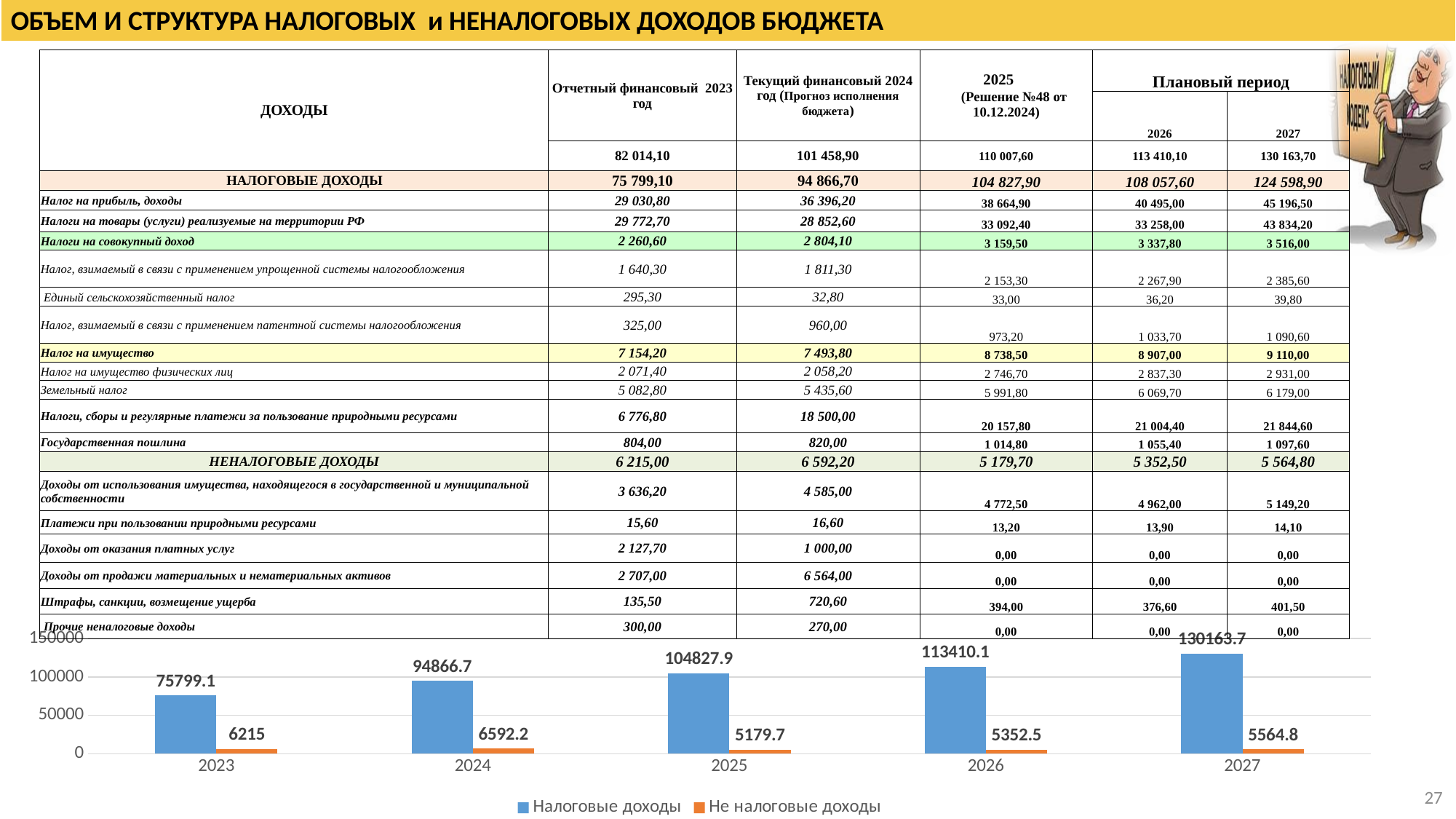
Do the values of Налоговые доходы rise or fall from 2023 to 2027 in the chart? rise What is the difference between Налоговые доходы in 2024 and 2023 in the chart? 19067.6 How many series does the chart legend list? 2 How many years are shown on the x axis of the chart? 5 Which colour represents Не налоговые доходы in the chart? orange Which year has the highest value of Налоговые доходы in the chart? 2027 What is the value of Не налоговые доходы for 2025 in the chart? 5179.7 Which is larger in the chart: Не налоговые доходы in 2024 or in 2026? 2024 What is the value of Налоговые доходы for 2023 in the chart? 75799.1 What type of chart is shown at the bottom of the slide? bar chart What is the value of Налоговые доходы for 2027 in the chart? 130163.7 Which year has the lowest value of Не налоговые доходы in the chart? 2025